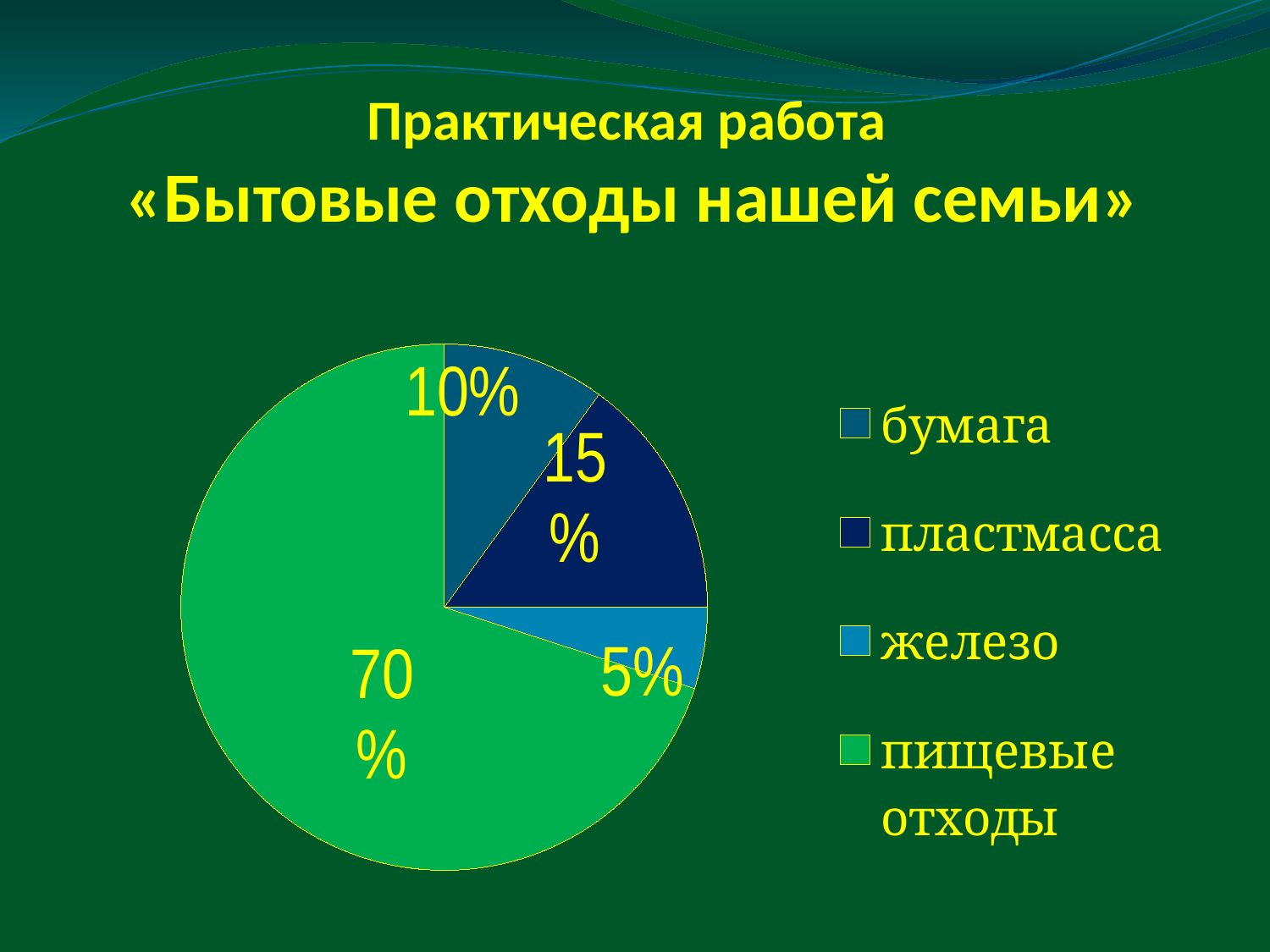
What share of the pie does железо (iron) have? 5% What share of the pie does пищевые отходы (food waste) have? 70% What is the difference between the shares of пластмасса and бумага? 5% Which is larger, the share of бумага or the share of железо? бумага How many categories does the pie chart have? 4 What share of the pie does пластмасса (plastic) have? 15% What colour is the slice for пищевые отходы? green What kind of chart is shown on the slide? pie chart What is the difference between the shares of пищевые отходы and пластмасса? 55% Which category has the smallest slice of the pie? железо What share of the pie does бумага (paper) have? 10% Which category has the largest slice of the pie? пищевые отходы